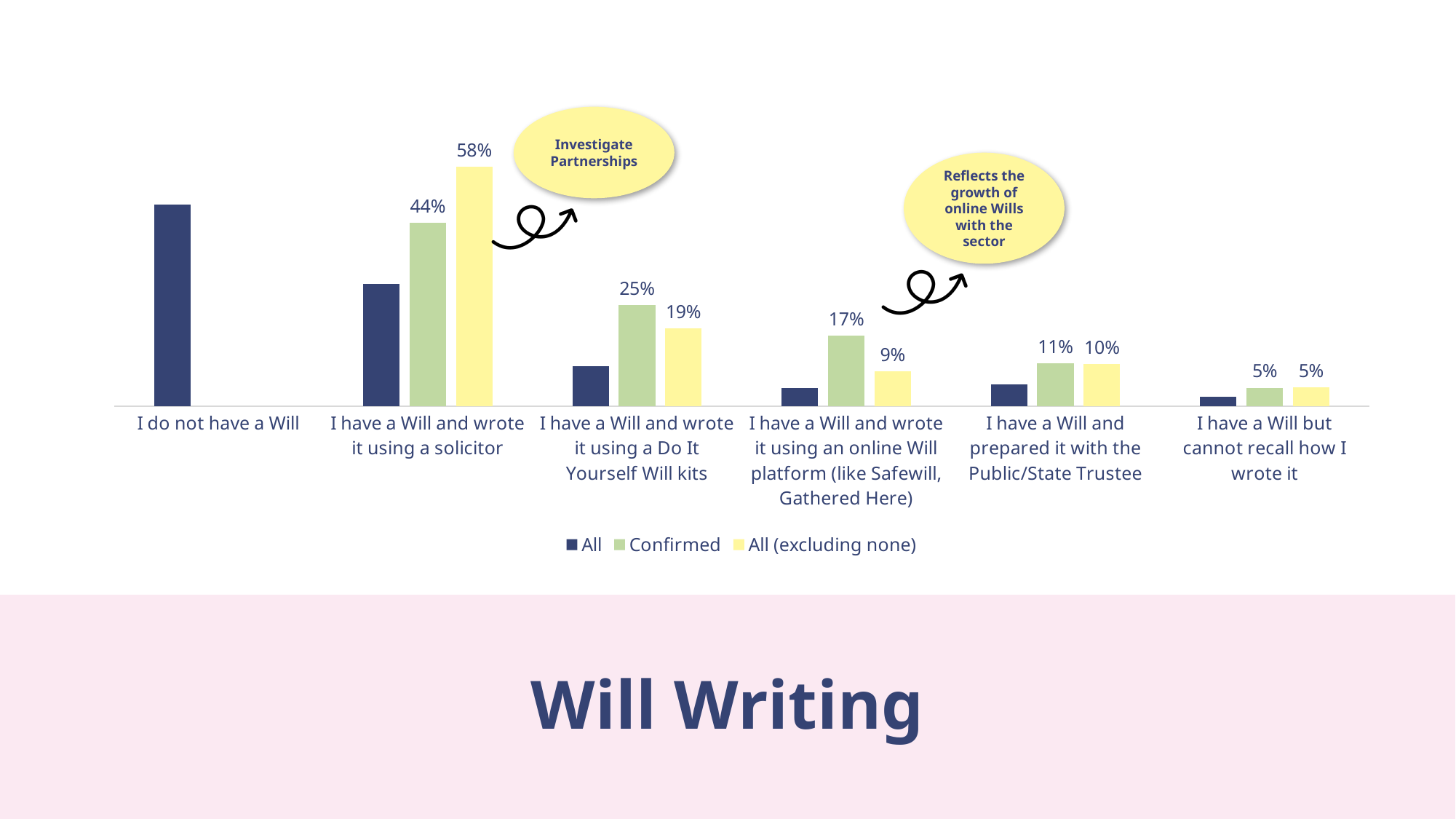
What is the Confirmed value for "I have a Will and wrote it using a solicitor"? 44% What is the Confirmed value for "I have a Will and wrote it using an online Will platform (like Safewill, Gathered Here)"? 17% Which category has the lowest Confirmed value? I have a Will but cannot recall how I wrote it How many categories are shown on the x axis? 6 What is the difference between the All (excluding none) and Confirmed values for "I have a Will and wrote it using a solicitor"? 14 percentage points For "I have a Will and wrote it using a Do It Yourself Will kits", which is larger: the Confirmed value or the All (excluding none) value? Confirmed Which category has the highest All (excluding none) value? I have a Will and wrote it using a solicitor In the All series, which bar is taller: "I do not have a Will" or "I have a Will and wrote it using a solicitor"? I do not have a Will What is the All (excluding none) value for "I have a Will and wrote it using a solicitor"? 58% What kind of chart is shown on the slide? Bar chart How many series does the legend list? 3 What is the All (excluding none) value for "I have a Will and wrote it using a Do It Yourself Will kits"? 19%